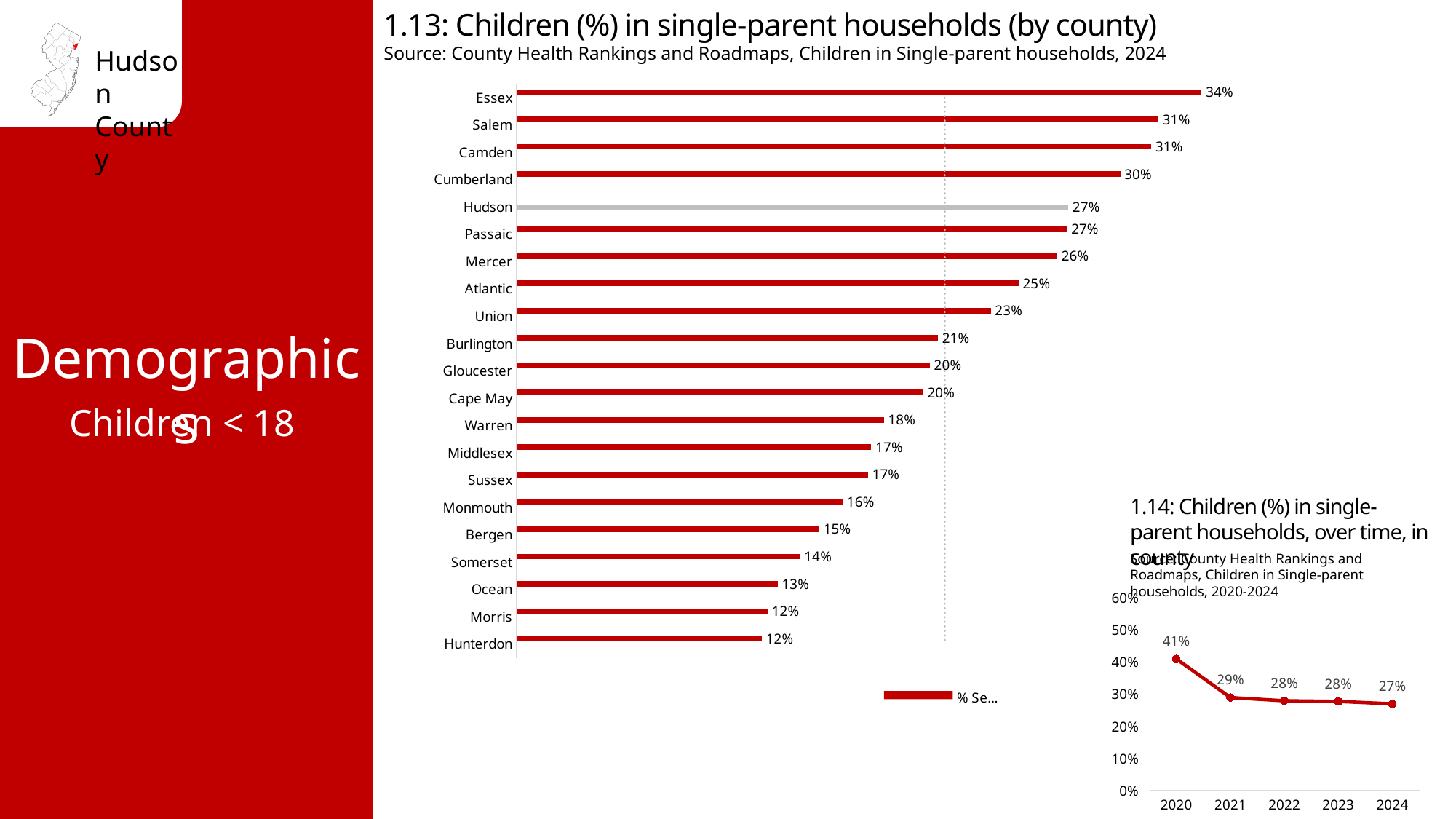
In chart 1.14 (Children in single-parent households over time), how many years are plotted? 5 In chart 1.13 (Children in single-parent households by county), which county has the highest value? Essex In chart 1.14 (Children in single-parent households over time), what is the difference between 2020 and 2021? 12% In chart 1.13 (Children in single-parent households by county), what is the value for Cumberland? 30% In chart 1.13 (Children in single-parent households by county), what is the difference between Essex and Hudson? 7% In chart 1.13 (Children in single-parent households by county), how many counties are shown? 21 What kind of chart is chart 1.13 (Children in single-parent households by county)? Bar chart In chart 1.14 (Children in single-parent households over time), do the values rise or fall from 2020 to 2024? Fall In chart 1.13 (Children in single-parent households by county), what is the value for Monmouth? 16% In chart 1.13 (Children in single-parent households by county), which is larger, Mercer or Bergen? Mercer In chart 1.13 (Children in single-parent households by county), what is the value for Hudson? 27% In chart 1.14 (Children in single-parent households over time), what is the value for 2020? 41%